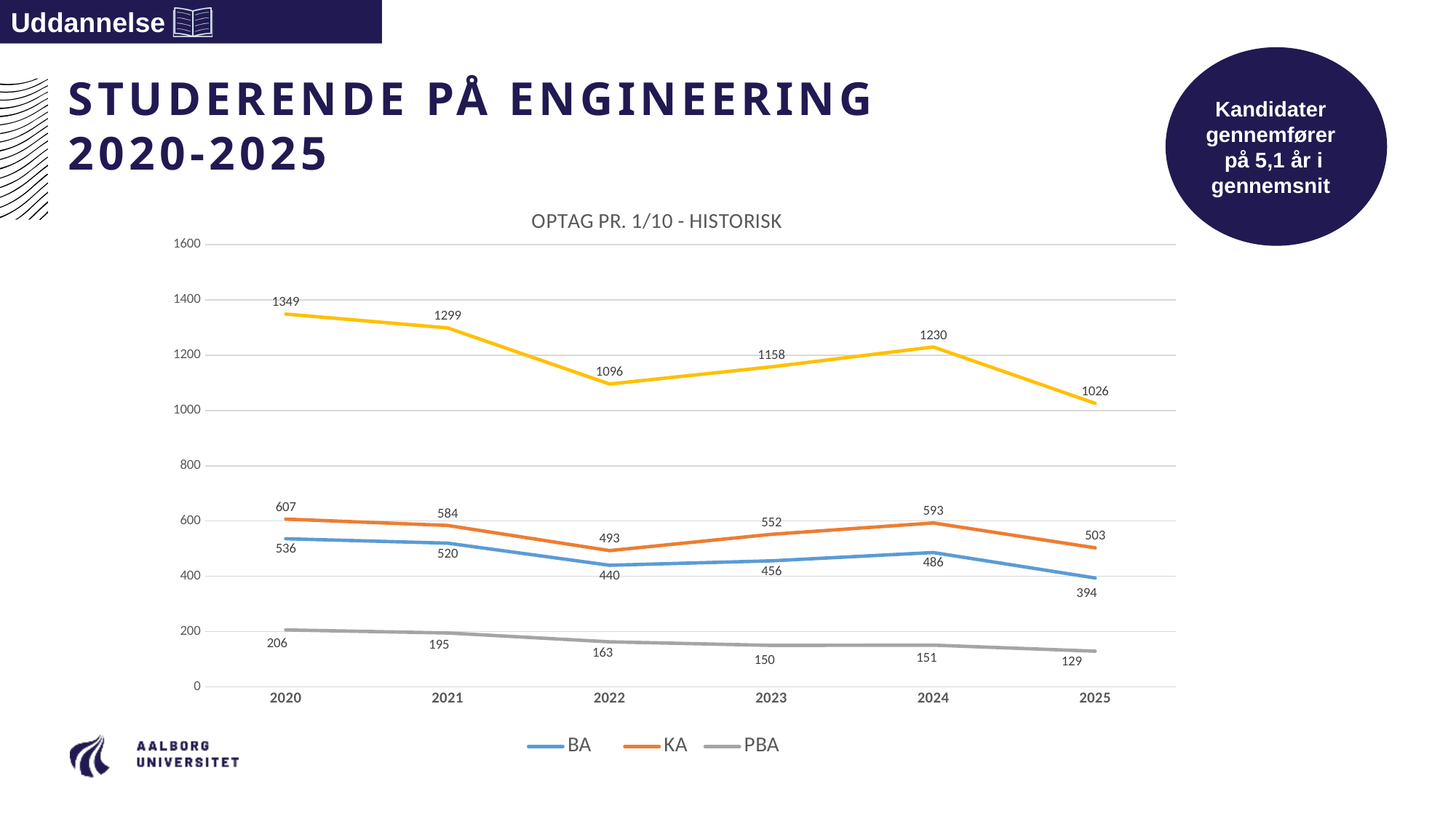
What is the value for BA in 2025? 394 In which year is the BA value highest? 2020 How many series does the legend list? 3 What is the value for PBA in 2023? 150 What type of chart is shown on the slide? Line chart What is the value for KA in 2020? 607 What is the title of the chart? OPTAG PR. 1/10 - HISTORISK In which year is the KA value lowest? 2022 How many years are shown on the x axis? 6 What is the difference between the KA and BA values in 2024? 107 Does the PBA value rise or fall from 2020 to 2025? Fall Which is larger in 2021, the BA value or the PBA value? BA